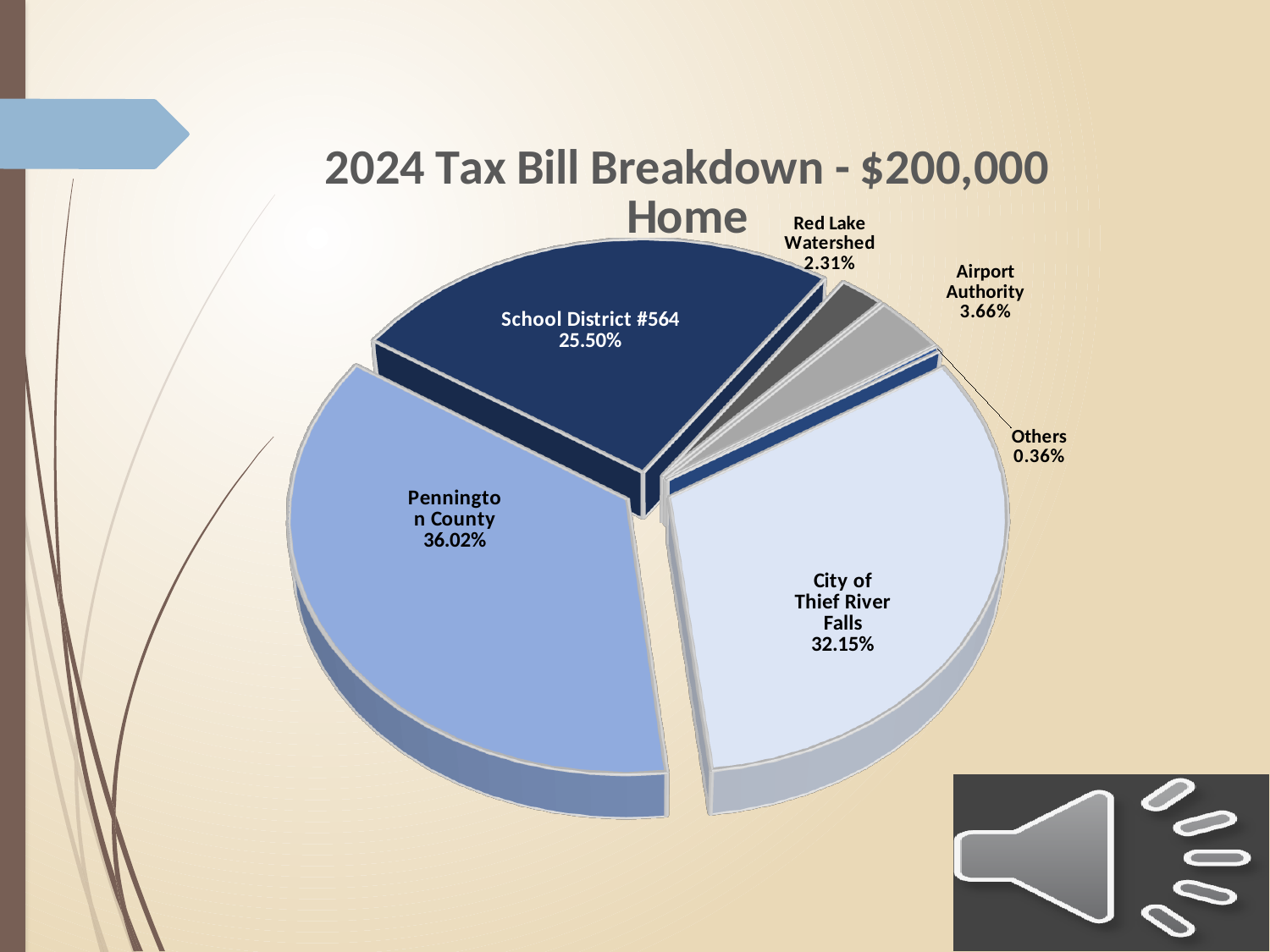
Which has a larger share, School District #564 or the City of Thief River Falls? City of Thief River Falls What share of the tax bill goes to Pennington County? 36.02% What share of the tax bill goes to School District #564? 25.50% What kind of chart is shown on the slide? Pie chart What percentage is shown for the Airport Authority? 3.66% How many slices does the pie chart have? 6 What is the difference in percentage points between Pennington County and the City of Thief River Falls? 3.87 What percentage of the tax bill goes to the City of Thief River Falls? 32.15% Which category receives the smallest share of the tax bill? Others Which category receives the largest share of the tax bill? Pennington County What percentage is shown for Red Lake Watershed? 2.31% What is the title of the chart? 2024 Tax Bill Breakdown - $200,000 Home